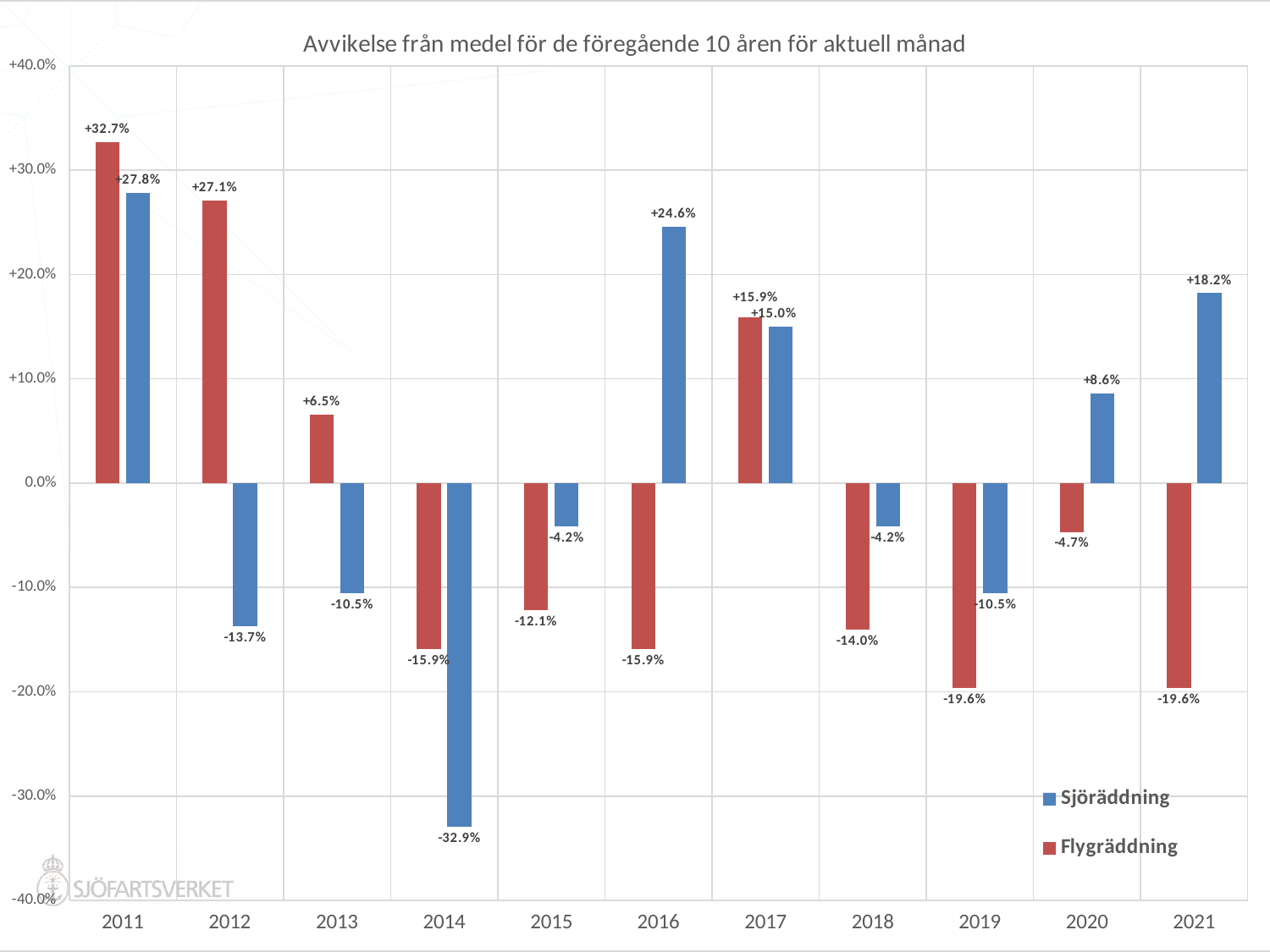
In which year is the Flygräddning value highest? 2011 What is the Flygräddning value for 2019? -19.6% How many series does the legend list? 2 What is the difference between the Flygräddning and Sjöräddning values in 2011? 4.9 percentage points What is the Sjöräddning value for 2016? +24.6% What is the Sjöräddning value for 2014? -32.9% Which colour represents Sjöräddning in the chart? Blue Which is larger in 2017, the Flygräddning value or the Sjöräddning value? Flygräddning What kind of chart is shown on the slide? Bar chart What is the Flygräddning value for 2013? +6.5% How many years are shown on the x axis? 11 In which year is the Sjöräddning value lowest? 2014